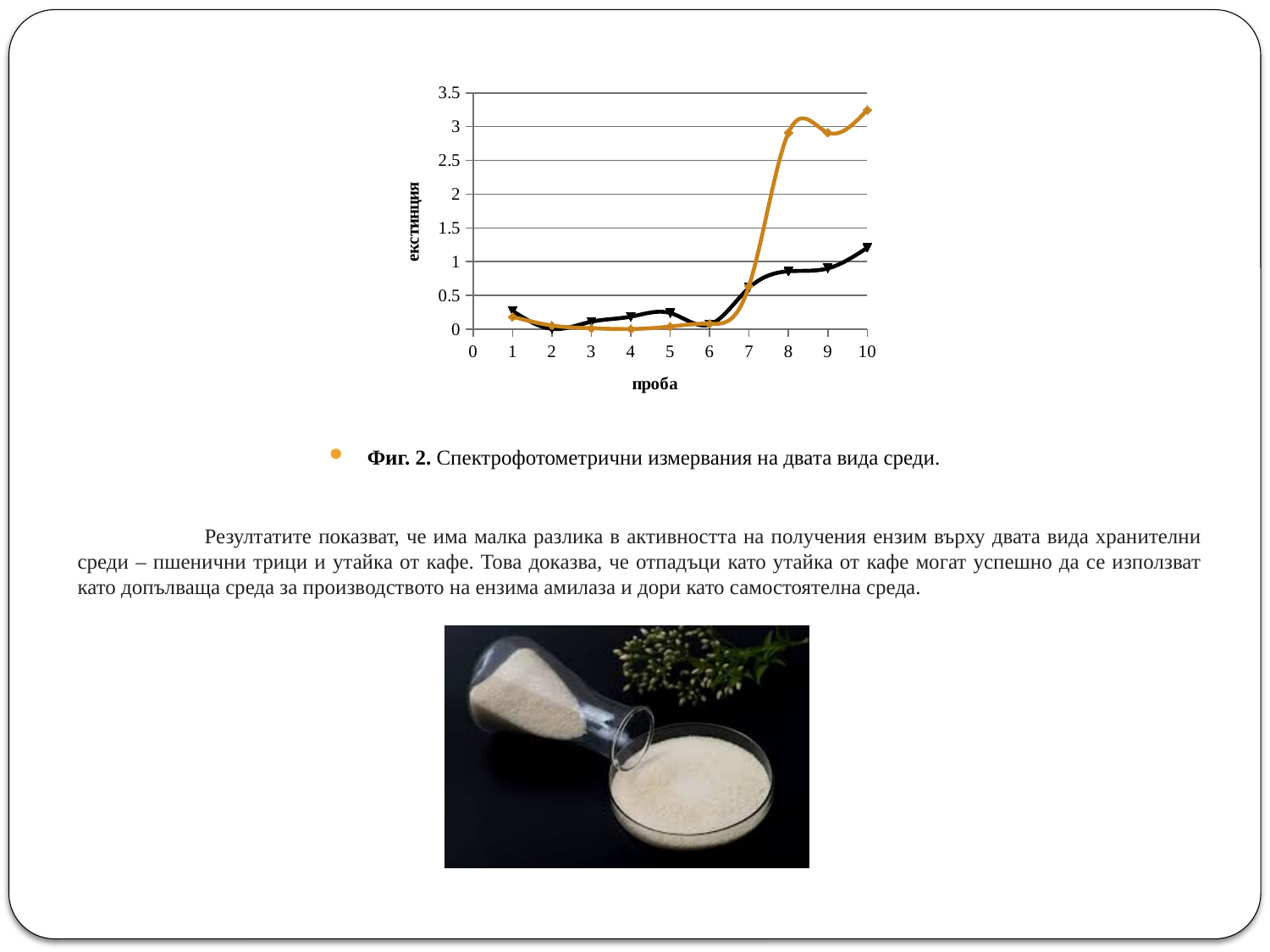
What kind of chart is shown on the slide? line chart How many data points does each line on the chart have? 10 Is the value of the black line at проба 5 greater or less than 0.5? less What is the label of the x axis of the chart? проба At which проба does the orange line reach its highest value? 10 Does the orange line rise or fall between проба 6 and проба 10? rise What is the label of the y axis of the chart? екстинция At проба 10, which line has the higher value, the orange line or the black line? the orange line Is the value of the orange line at проба 7 greater or less than 0.5? greater Is the value of the black line at проба 10 greater or less than 1? greater How many lines (series) are plotted on the chart? 2